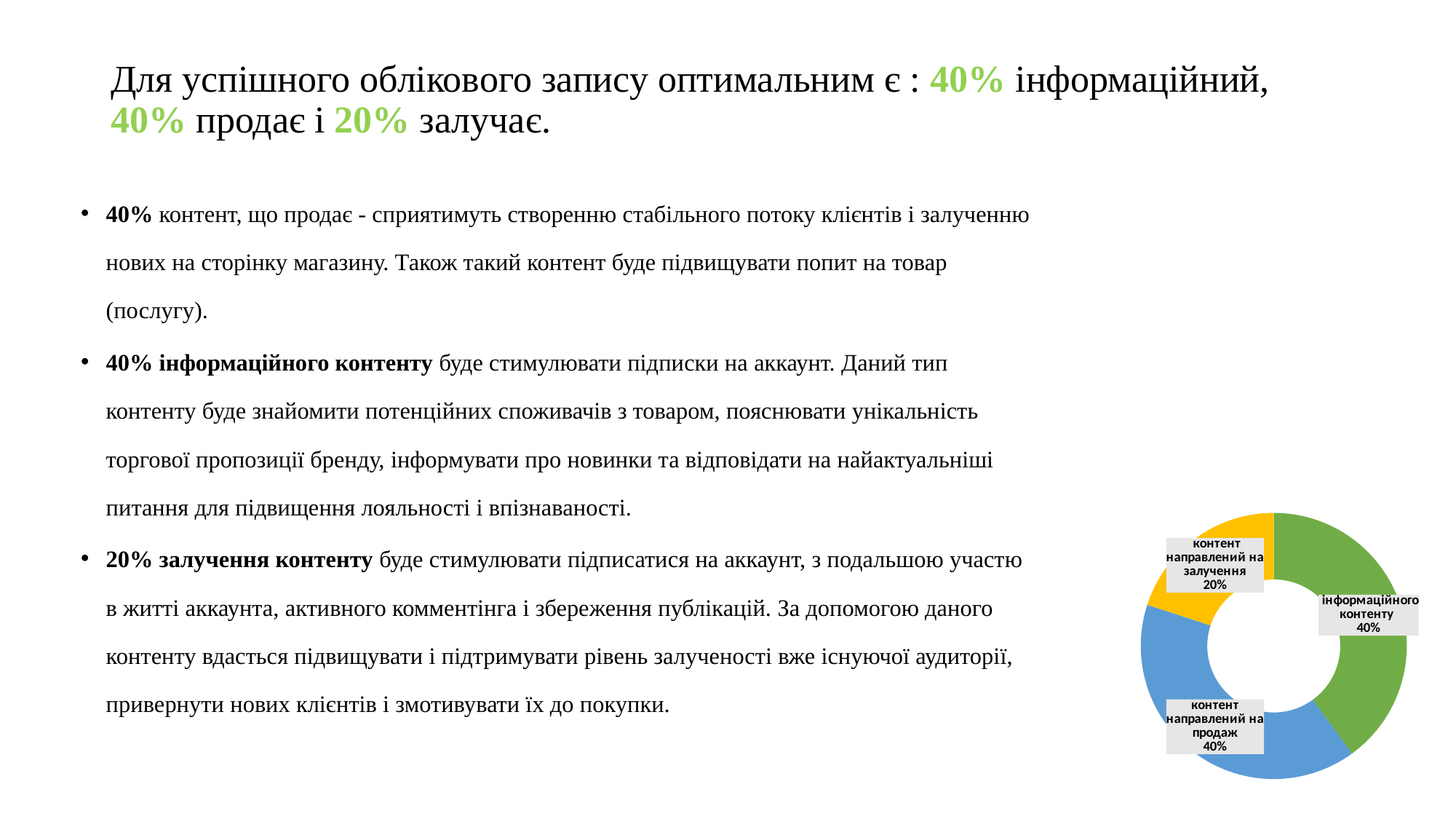
What colour is the slice for "інформаційного контенту"? Green What kind of chart is shown on the slide? Doughnut (pie) chart What is the combined share of the two 40% slices in the chart? 80% What colour is the slice for "контент направлений на залучення"? Yellow How many slices does the chart have? 3 Which category has the smallest slice in the chart? контент направлений на залучення What percentage is shown for "контент направлений на залучення" in the chart? 20% Which is larger in the chart: the slice for "інформаційного контенту" or the slice for "контент направлений на залучення"? інформаційного контенту What percentage is shown for "контент направлений на продаж" in the chart? 40% What share of the doughnut chart is labelled "інформаційного контенту"? 40% By how many percentage points does the "контент направлений на продаж" slice exceed the "контент направлений на залучення" slice? 20 percentage points